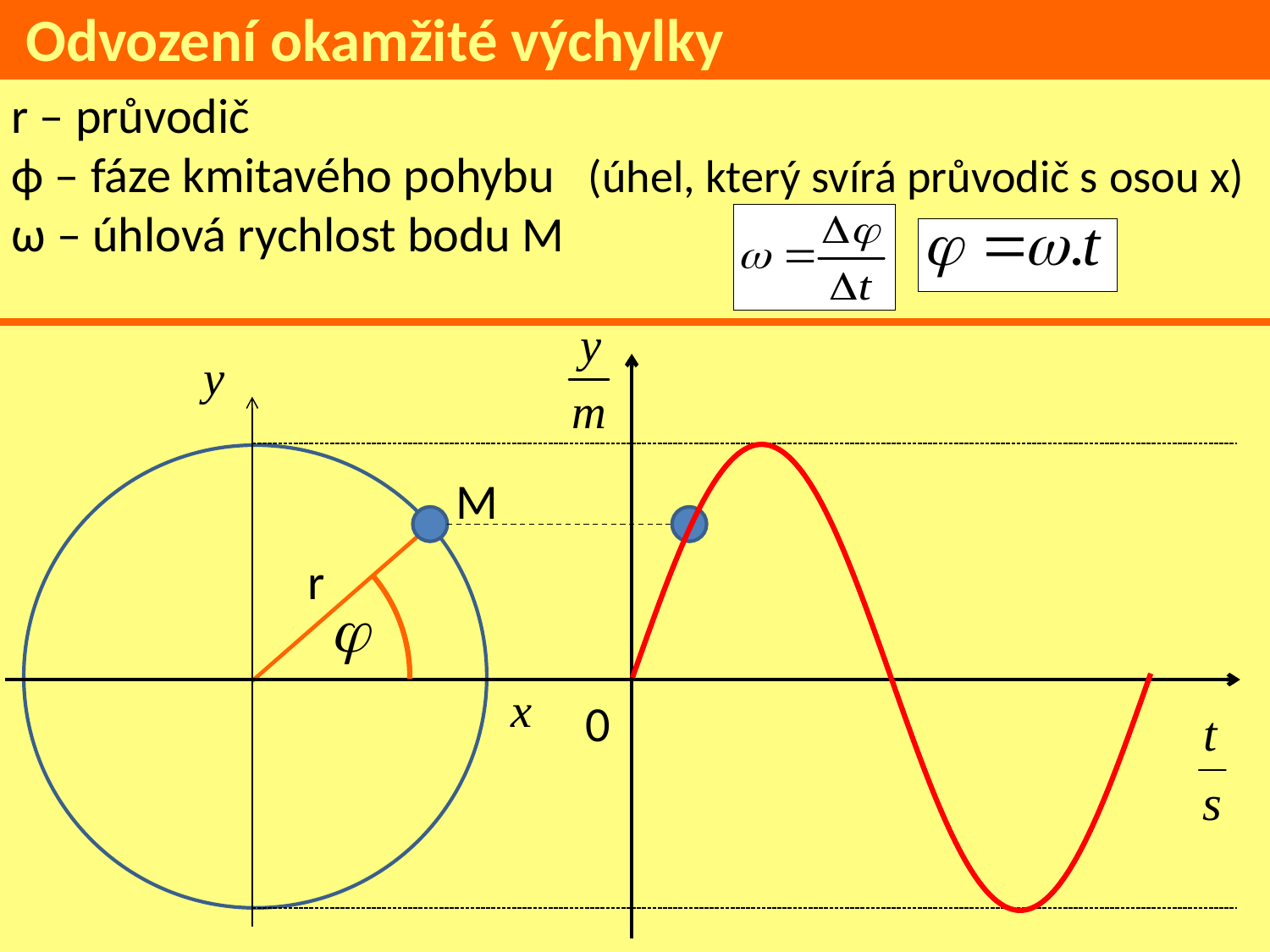
What colour is the curve plotted on the right-hand graph? red What label is written on the vertical axis of the right-hand graph? y/m What kind of chart is the graph on the right-hand side of the slide (with axes y/m and t/s)? line chart On the right-hand graph, does the red curve rise or fall immediately after t = 0? rise How many complete oscillations (full periods) does the red curve on the right-hand graph show? 1